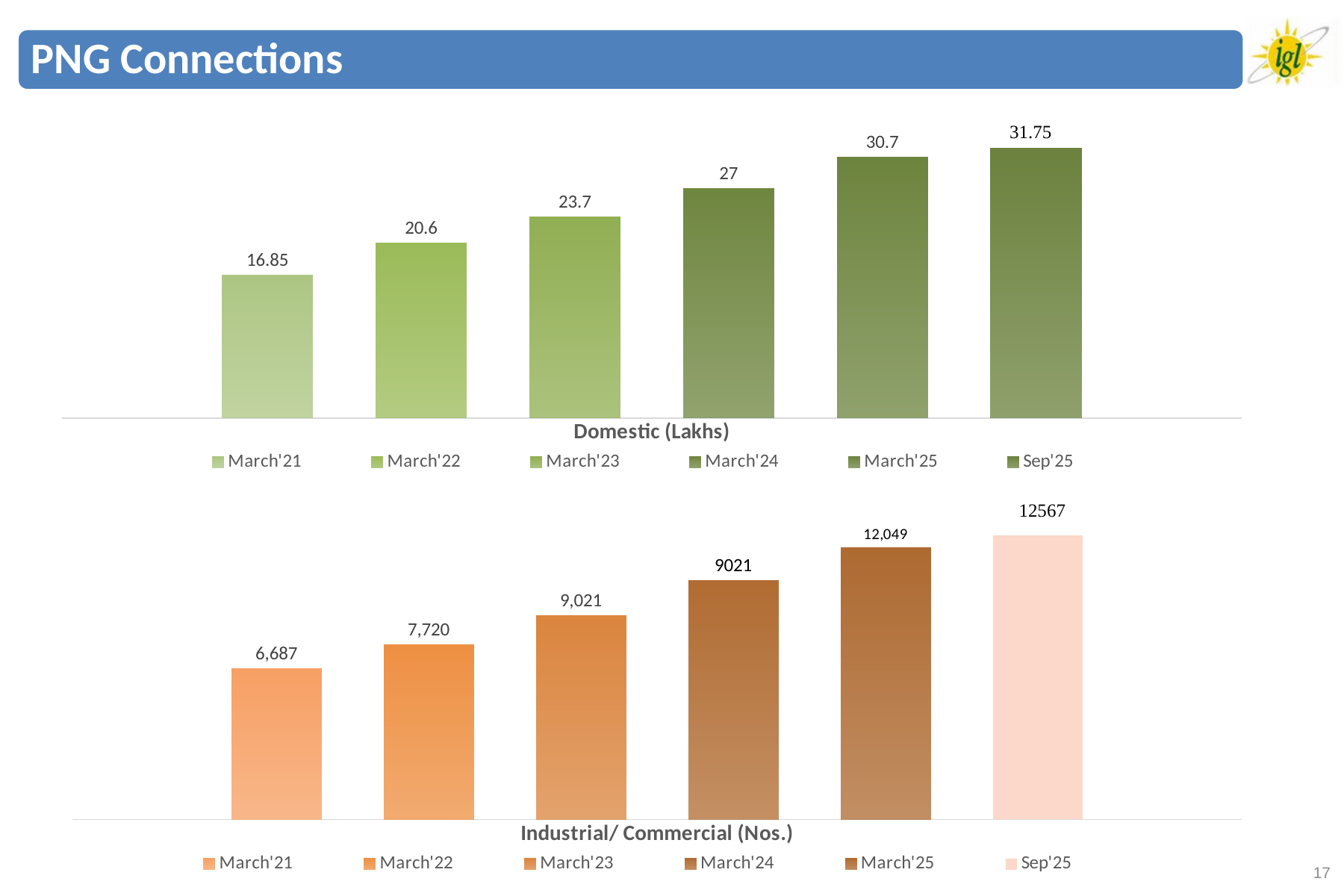
In the Domestic (Lakhs) chart, how many bars are plotted? 6 In the Industrial/ Commercial (Nos.) chart, which is larger, the value for March'21 or the value for March'22? March'22 In the Domestic (Lakhs) chart, which period has the lowest value? March'21 In the Industrial/ Commercial (Nos.) chart, what is the difference between the March'22 and March'21 values? 1,033 In the Domestic (Lakhs) chart, what is the value for Sep'25? 31.75 In the Domestic (Lakhs) chart, what is the value for March'21? 16.85 In the Domestic (Lakhs) chart, do the values rise or fall from March'21 to Sep'25? rise What type of chart is the Domestic (Lakhs) chart? bar chart In the Industrial/ Commercial (Nos.) chart, what is the value for March'22? 7,720 In the Industrial/ Commercial (Nos.) chart, what is the value for March'25? 12,049 In the Domestic (Lakhs) chart, what is the difference between the March'25 and March'24 values? 3.7 In the Industrial/ Commercial (Nos.) chart, which period has the highest value? Sep'25